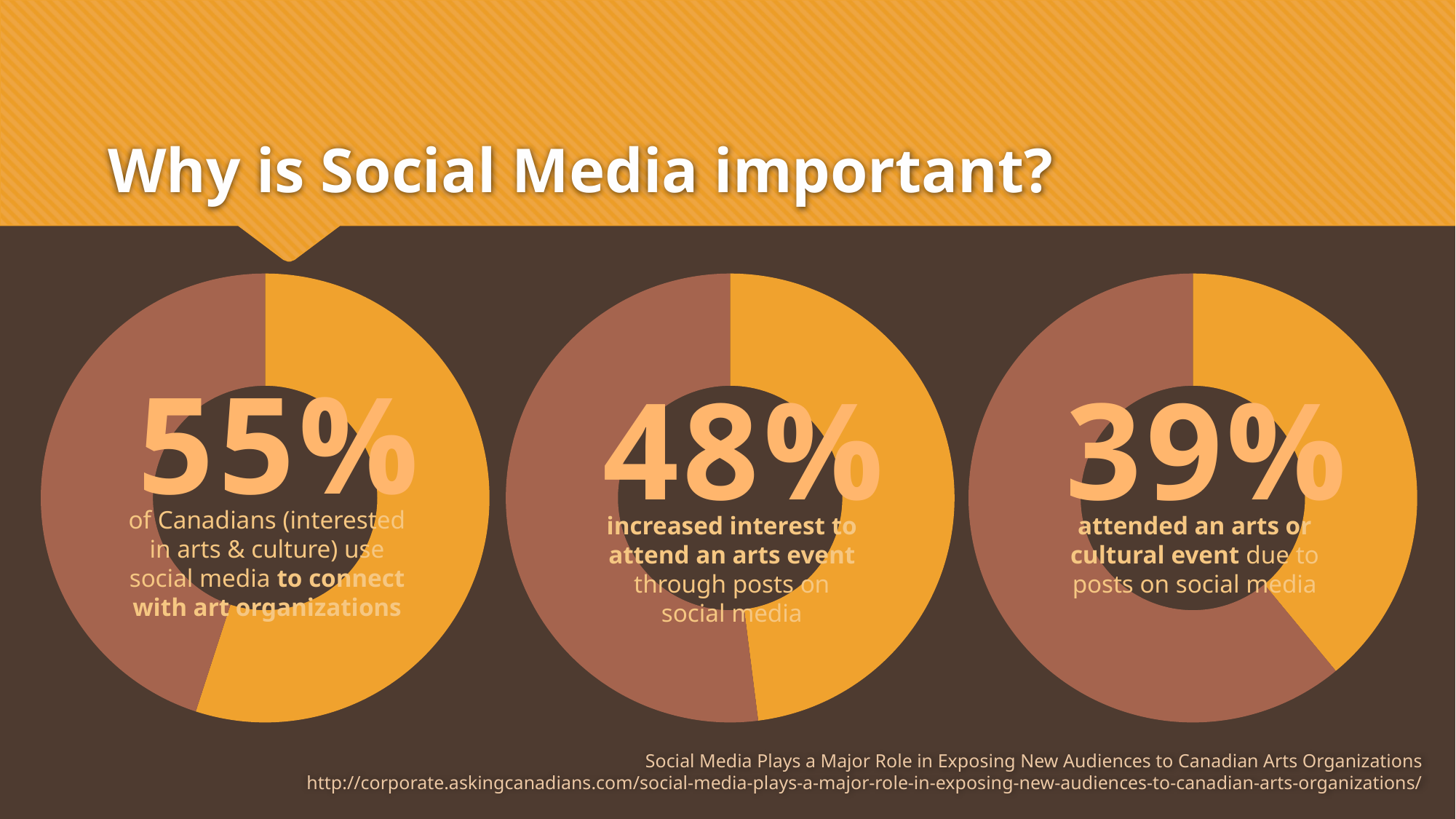
In the left donut chart, what share of the ring is filled by the orange segment? 55% What percentage is shown in the right donut chart, for those who attended an arts or cultural event due to posts on social media? 39% What is the difference between the percentage in the left chart (55%) and the percentage in the right chart (39%)? 16 percentage points Which is larger: the percentage in the middle chart or the percentage in the right chart? The middle chart (48%) What is the difference between the percentage in the left chart (55%) and the percentage in the middle chart (48%)? 7 percentage points What percentage is shown in the left donut chart, for Canadians who use social media to connect with art organizations? 55% How many donut charts are shown on the slide? 3 Which of the three donut charts shows the lowest percentage? The right chart (39%) Which of the three donut charts shows the highest percentage? The left chart (55%) What kind of chart is used to display the three percentages on the slide? Donut (pie) chart What is the title of the slide containing the three donut charts? Why is Social Media important? What percentage is shown in the middle donut chart, for increased interest to attend an arts event through posts on social media? 48%